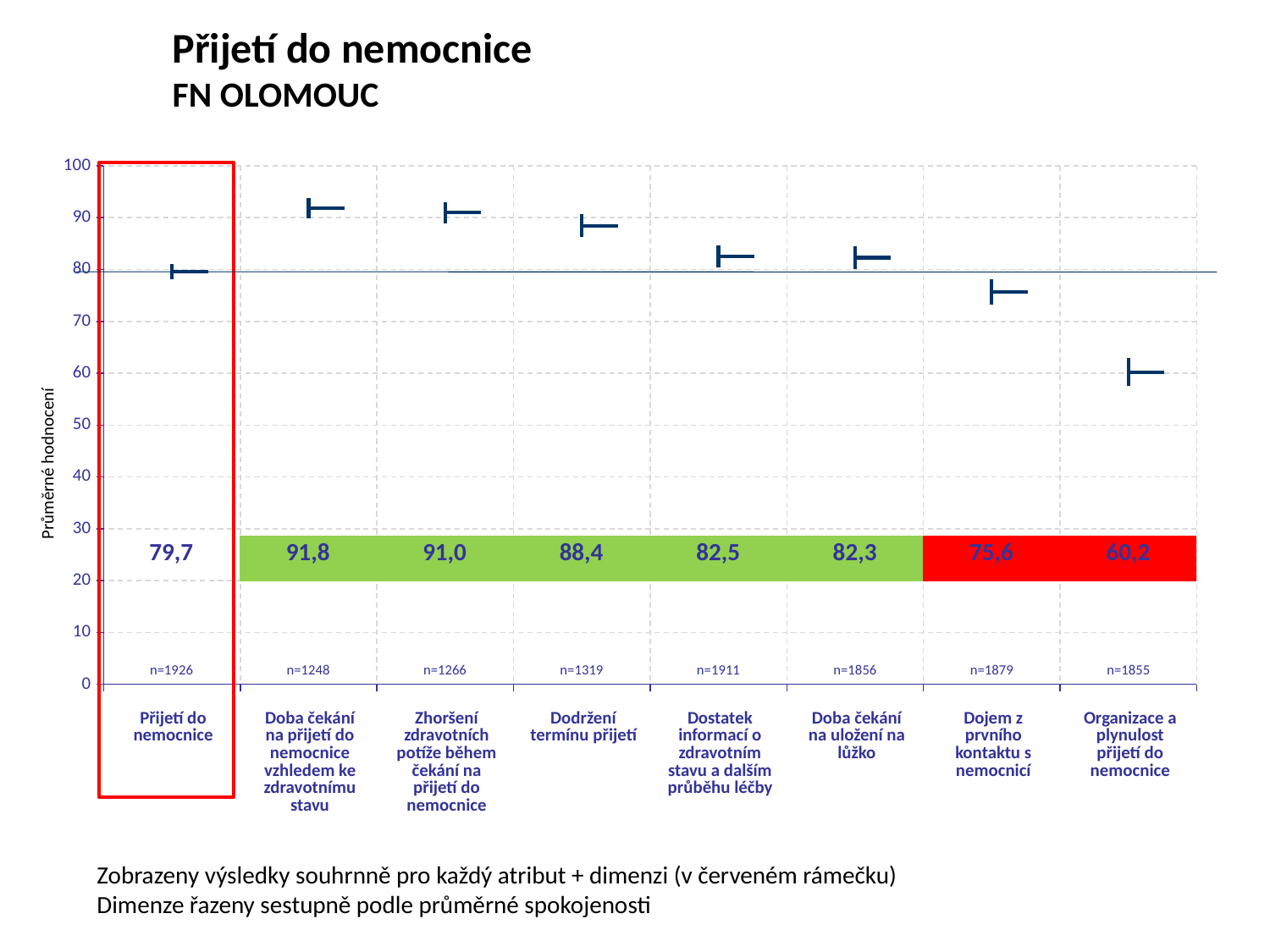
How many attributes are highlighted with a red band in the chart? 2 What is the average rating for 'Dodržení termínu přijetí'? 88,4 What is the difference between the average ratings for 'Doba čekání na přijetí do nemocnice vzhledem ke zdravotnímu stavu' and 'Organizace a plynulost přijetí do nemocnice'? 31,6 Which has a higher average rating: 'Dostatek informací o zdravotním stavu a dalším průběhu léčby' or 'Dojem z prvního kontaktu s nemocnicí'? Dostatek informací o zdravotním stavu a dalším průběhu léčby What is the sample size (n) shown for 'Zhoršení zdravotních potíže během čekání na přijetí do nemocnice'? n=1266 Which attribute has the highest average rating? Doba čekání na přijetí do nemocnice vzhledem ke zdravotnímu stavu What is the label of the vertical axis of the chart? Průměrné hodnocení What is the overall average rating for 'Přijetí do nemocnice' (the category in the red frame)? 79,7 Is the average rating for 'Dojem z prvního kontaktu s nemocnicí' greater or less than 80? less Which attribute has the lowest average rating? Organizace a plynulost přijetí do nemocnice What is the average rating for 'Organizace a plynulost přijetí do nemocnice'? 60,2 How many categories are shown on the x axis of the chart? 8